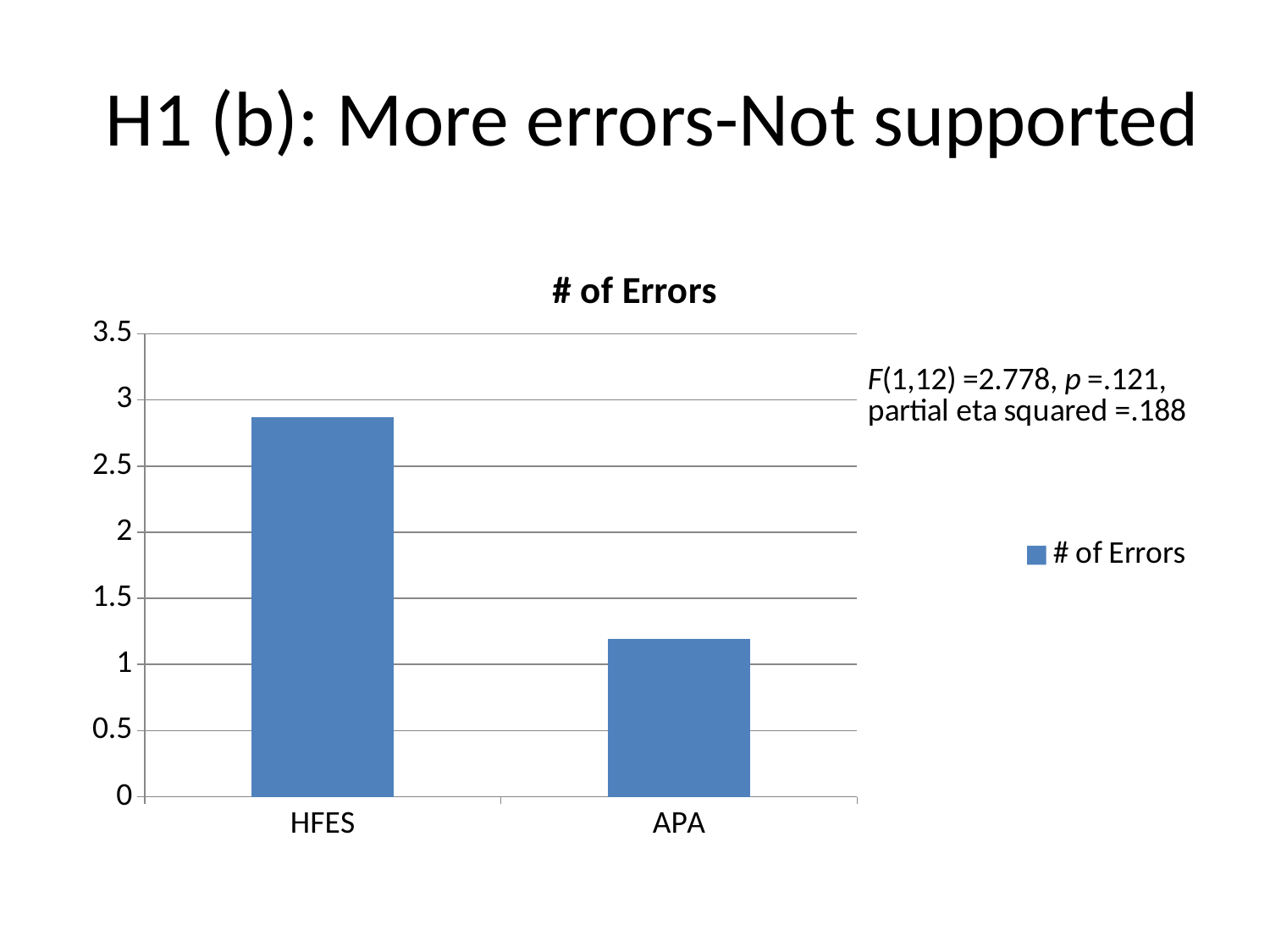
Is the value for HFES greater or less than 3? less Which category has the lowest number of errors? APA What is the title of the chart? # of Errors Is the value for APA greater or less than 1? greater Which category has the highest number of errors? HFES What kind of chart is shown on the slide? bar chart Do the values rise or fall from HFES to APA along the x axis? fall How many categories are shown on the x axis of the chart? 2 Is the value for APA greater or less than 1.5? less How many series does the legend list? 1 Which has more errors, HFES or APA? HFES